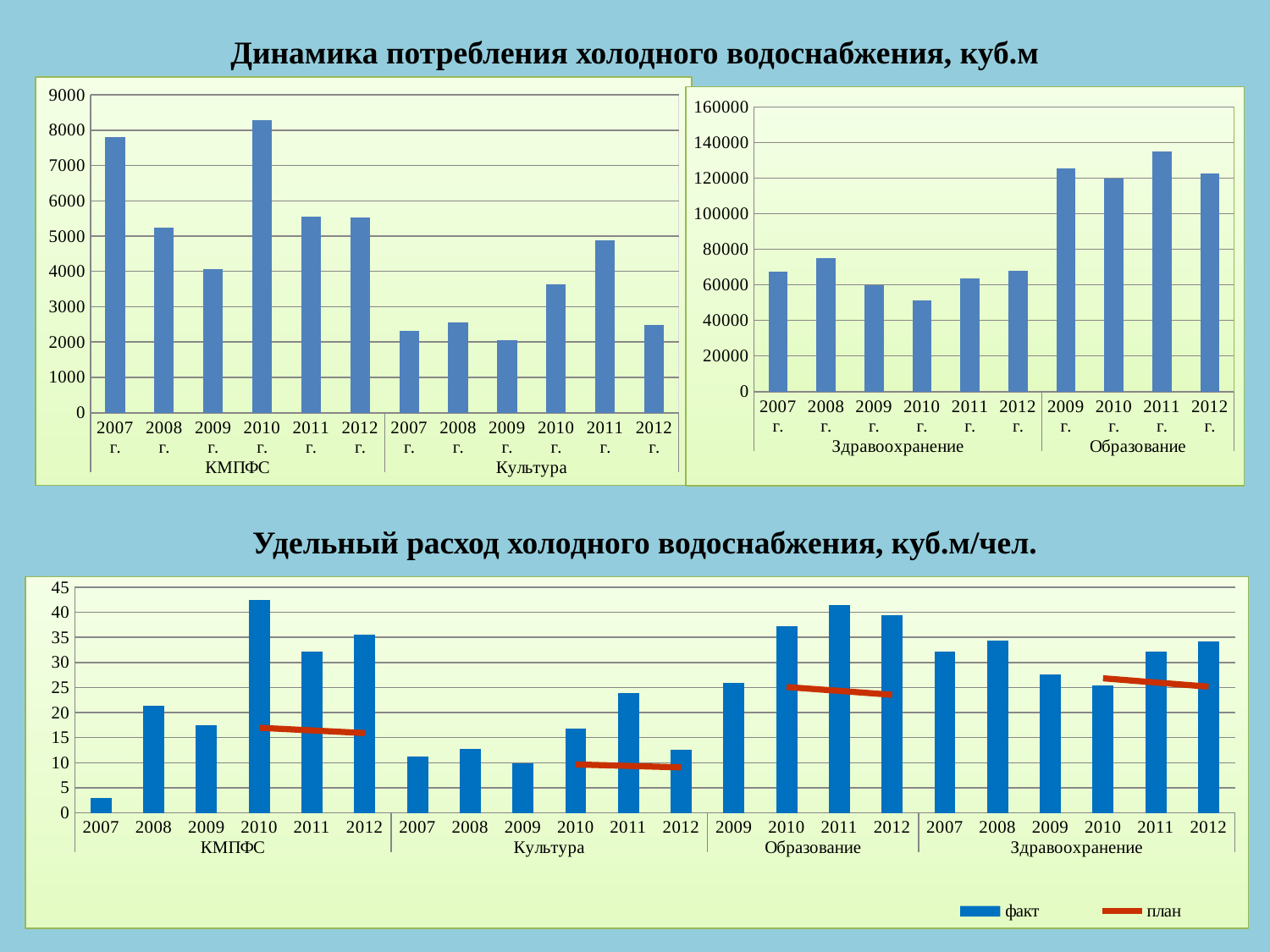
In the bottom chart, how many series does the legend list? 2 In the bottom chart (Удельный расход холодного водоснабжения), which year has the highest факт value for КМПФС? 2010 In the bottom chart, is the факт value for Образование in 2011 greater or less than 40? greater In the top-right chart, how many bars are plotted in total? 10 In the top-right chart, which year has the lowest value for Здравоохранение? 2010 г. In the top-left chart, which year has the lowest value for Культура? 2009 г. In the top-right chart, which year has the highest value for Образование? 2011 г. In the top-right chart, is the value for Здравоохранение in 2008 г. greater or less than 60000? greater What type of chart is the top-left chart? Bar chart In the top-left chart (Динамика потребления холодного водоснабжения), which year has the highest value for КМПФС? 2010 г. In the top-left chart, is the value for КМПФС in 2009 г. greater or less than 5000? less